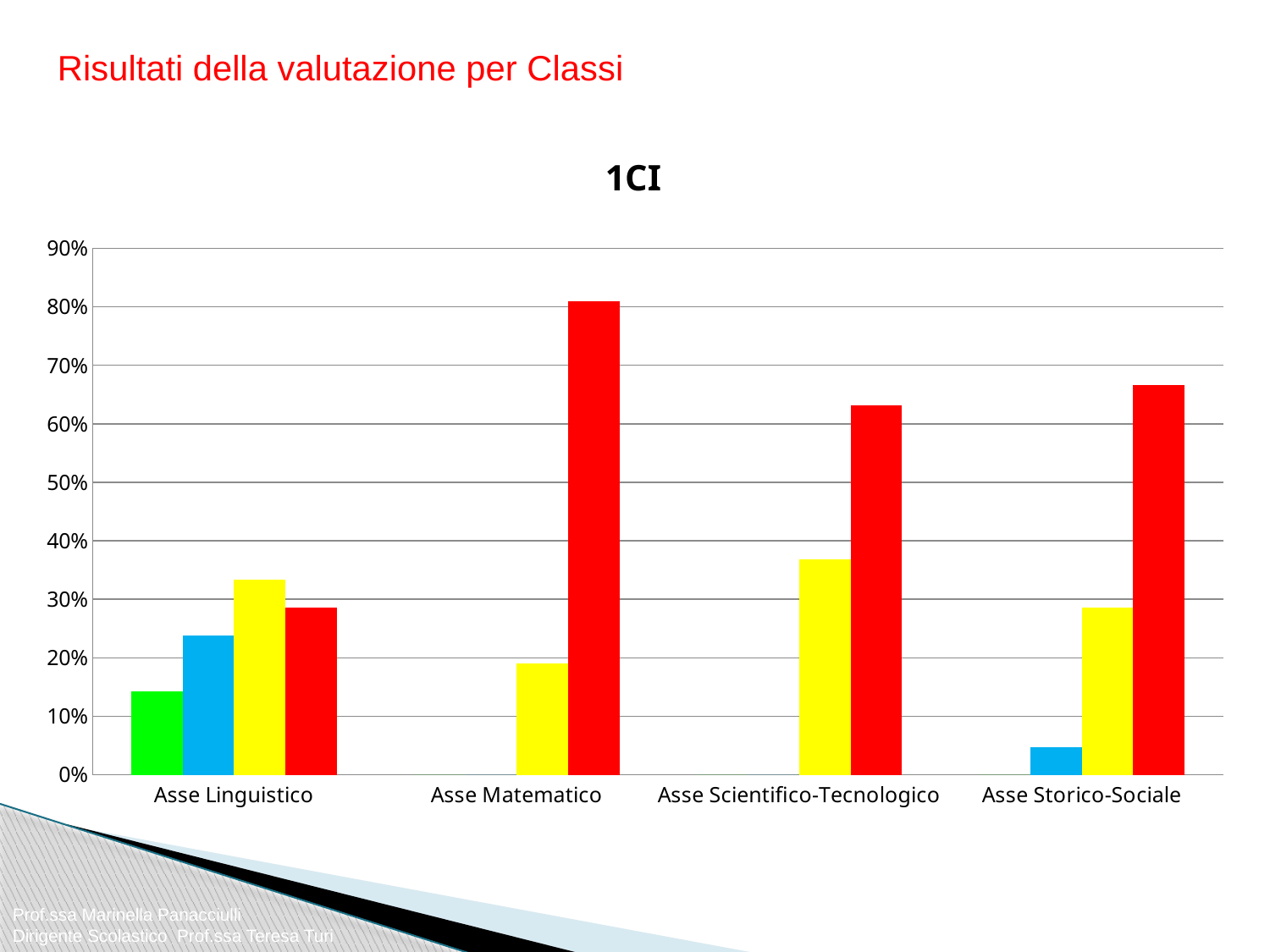
Is the value of the green bar for Asse Linguistico greater or less than 20%? less What kind of chart is shown on the slide? bar chart Is the value of the blue bar for Asse Storico-Sociale greater or less than 10%? less Which category has the tallest red bar? Asse Matematico Which category has the shortest red bar? Asse Linguistico Is the value of the red bar for Asse Scientifico-Tecnologico greater or less than 60%? greater How many categories are shown on the x axis of the chart? 4 Which category is the only one with a green bar? Asse Linguistico For Asse Scientifico-Tecnologico, which is taller, the yellow bar or the red bar? the red bar What is the title of the chart? 1CI